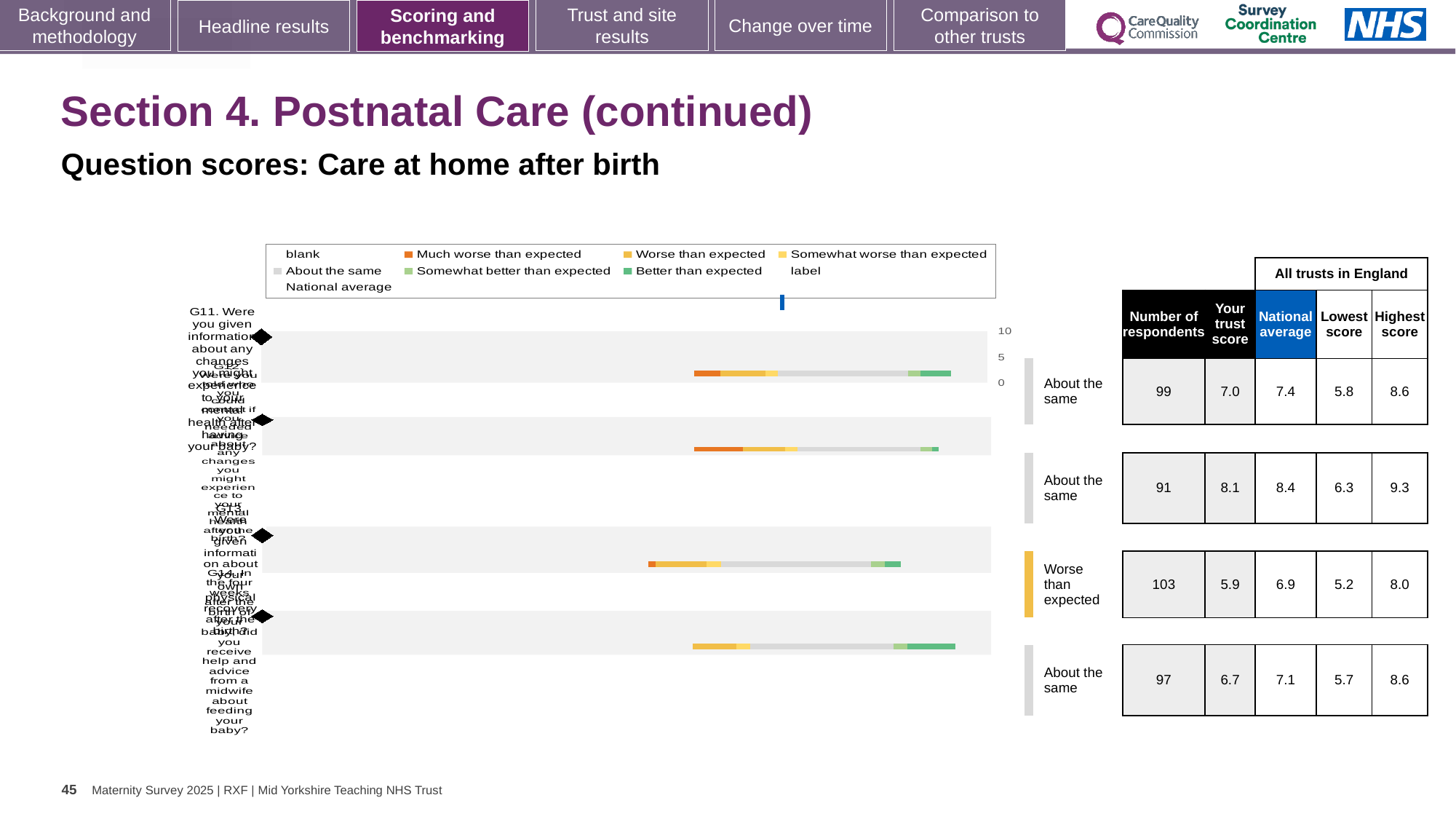
What kind of chart is shown on the slide? Bar chart In the table, what is the trust score for the row rated 'Worse than expected'? 5.9 In the table, what is the highest score in England for the second row? 9.3 Which of the four rows is rated 'Worse than expected' rather than 'About the same'? The third row Which row has the lowest 'Your trust score' in the table? The third row (5.9) Which row has the highest 'Your trust score' in the table? The second row (8.1) In the table, what is the number of respondents for the third row (rated 'Worse than expected')? 103 Which legend entry is shown in orange? Much worse than expected How many entries does the chart legend list? 9 How many question rows (bars) are plotted in the chart? 4 For the third row, what is the difference between the national average (6.9) and the trust score (5.9)? 1.0 In the table, what is the national average for the first row? 7.4